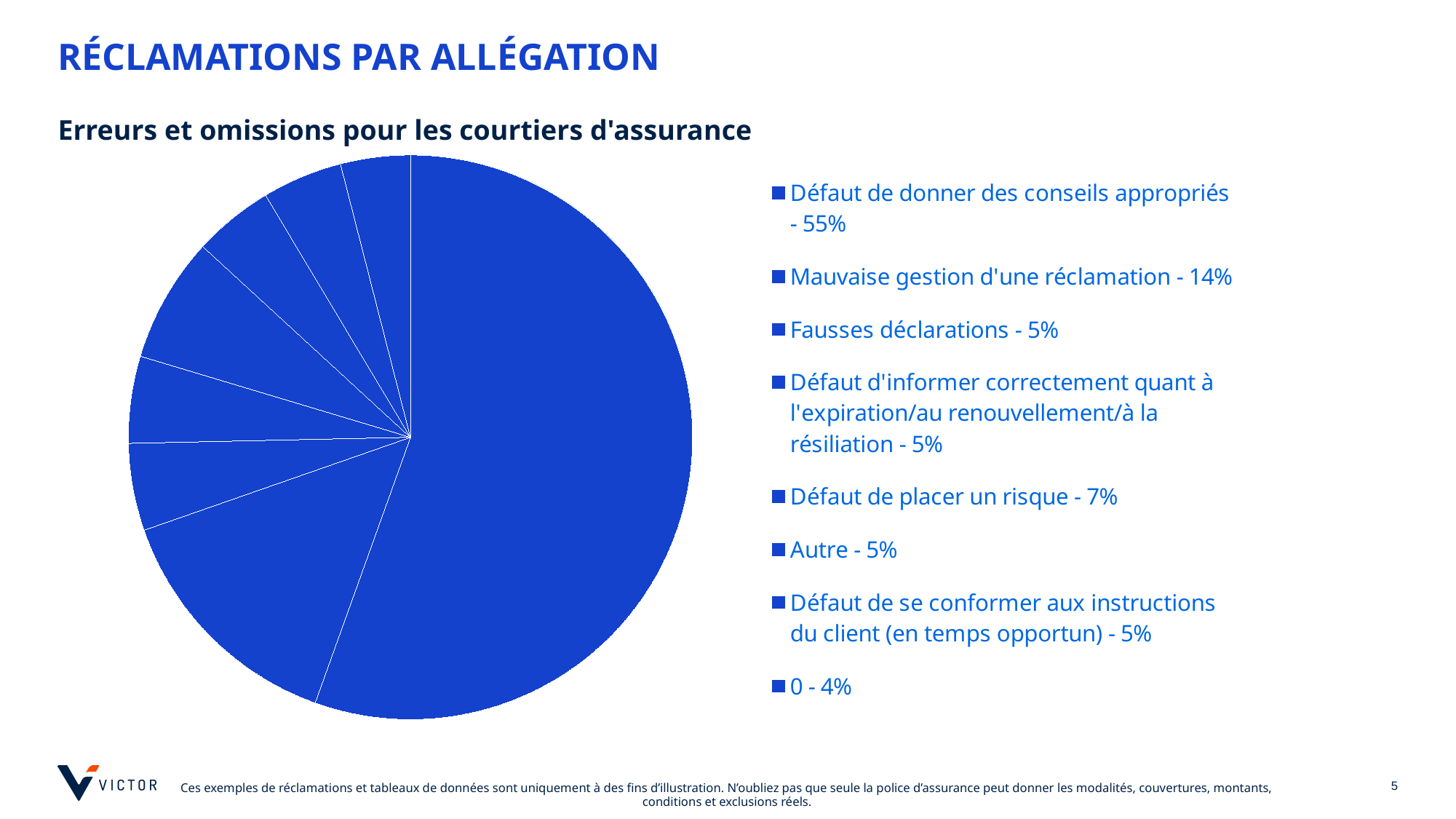
What percentage is shown for "Fausses déclarations"? 5% Which allegation category has the largest share of the pie? Défaut de donner des conseils appropriés What share of claims is attributed to "Défaut de donner des conseils appropriés"? 55% What is the difference in percentage points between "Défaut de donner des conseils appropriés" and "Mauvaise gestion d'une réclamation"? 41 What kind of chart is shown on the slide? Pie chart What is the title of the slide containing the pie chart? RÉCLAMATIONS PAR ALLÉGATION What percentage is shown for "Défaut de placer un risque"? 7% What is the smallest percentage listed in the legend? 4% What percentage is shown for "Mauvaise gestion d'une réclamation"? 14% How many categories does the legend list? 8 Which is larger: the share for "Défaut de placer un risque" or the share for "Autre"? Défaut de placer un risque What is the subtitle shown above the pie chart? Erreurs et omissions pour les courtiers d'assurance